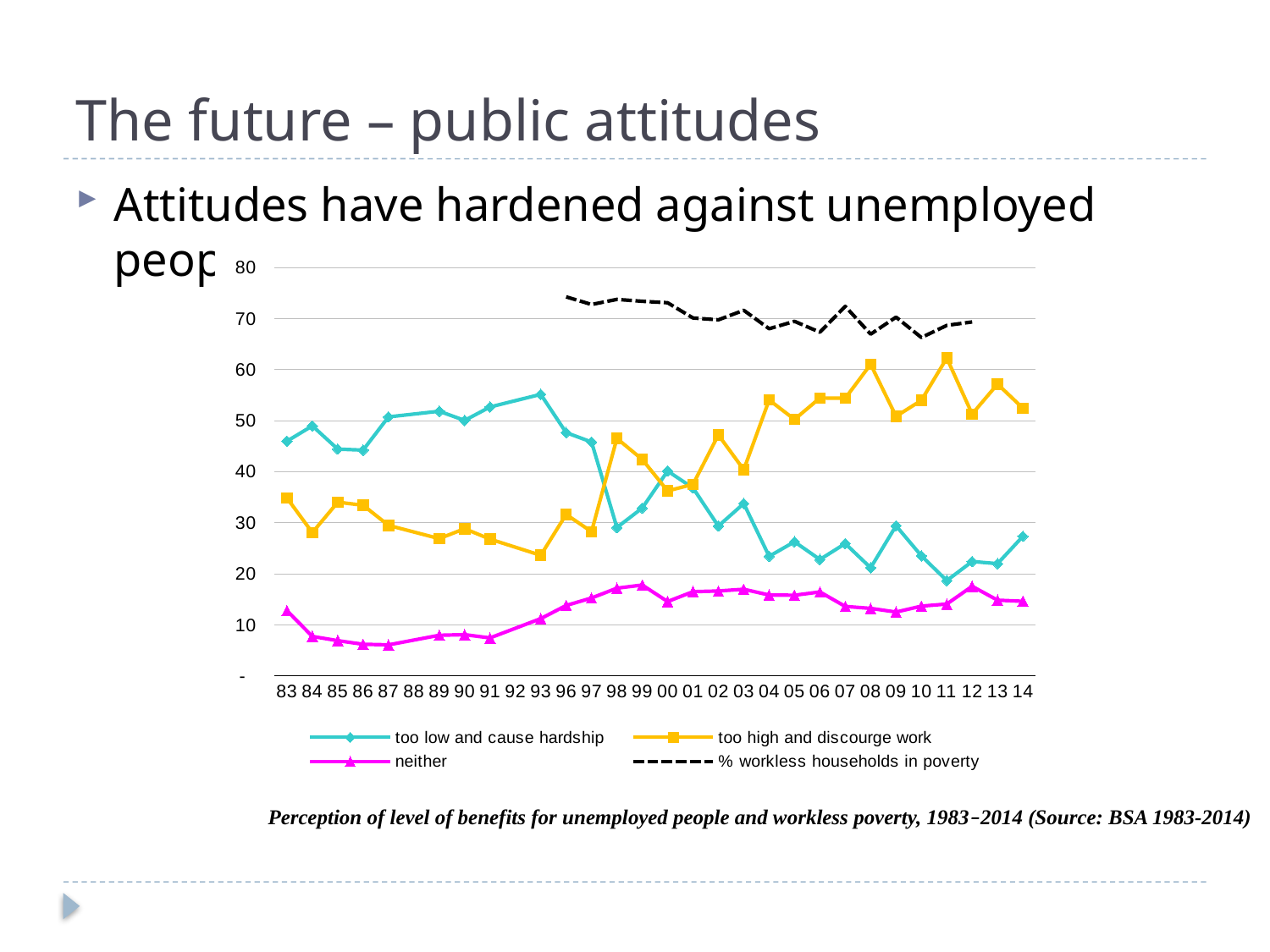
Is the value for 'too high and discourge work' in 11 greater or less than 60? greater In 83, which is larger: 'too low and cause hardship' or 'too high and discourge work'? too low and cause hardship What kind of chart is shown on the slide? line chart Overall, does the 'too high and discourge work' series rise or fall from 83 to 14? rise In 14, which is larger: 'too high and discourge work' or 'too low and cause hardship'? too high and discourge work How many series does the chart's legend list? 4 Is the value for '% workless households in poverty' in 96 greater or less than 70? greater How many years are plotted along the x axis of the chart? 30 Which series is drawn as a dashed black line in the chart? % workless households in poverty Is the value for 'too low and cause hardship' in 93 greater or less than 50? greater